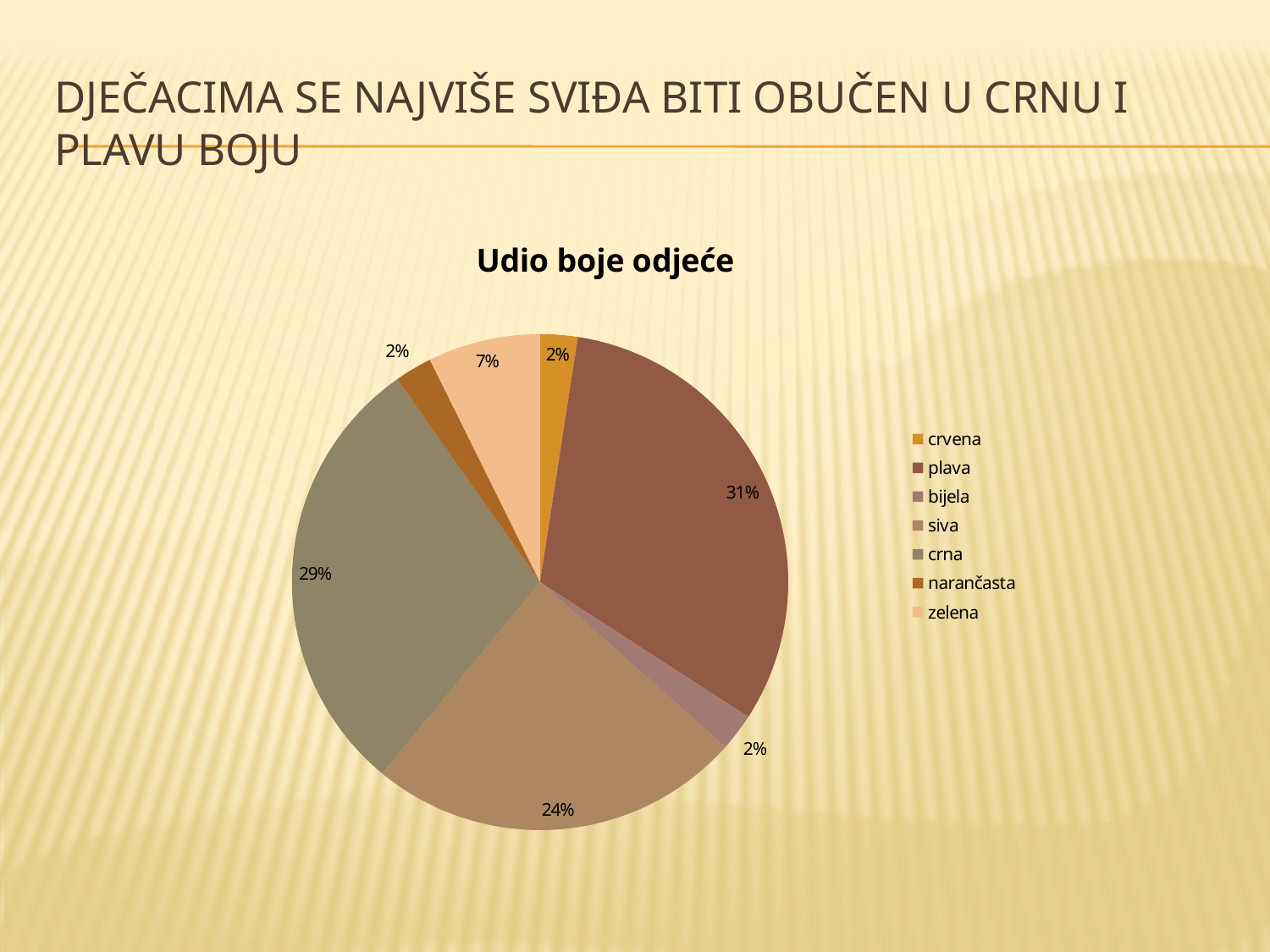
What type of chart is shown on the slide? pie chart What is the difference between the shares for plava and crna? 2% What is the title of the chart? Udio boje odjeće Which category has the largest share of the pie? plava How many categories does the legend list? 7 What share of the pie does crna have? 29% What is the value for crvena? 2% What share of the pie does plava have? 31% What share of the pie does zelena have? 7% What is the difference between the shares for siva and zelena? 17% Which is larger, the share for crna or the share for siva? crna